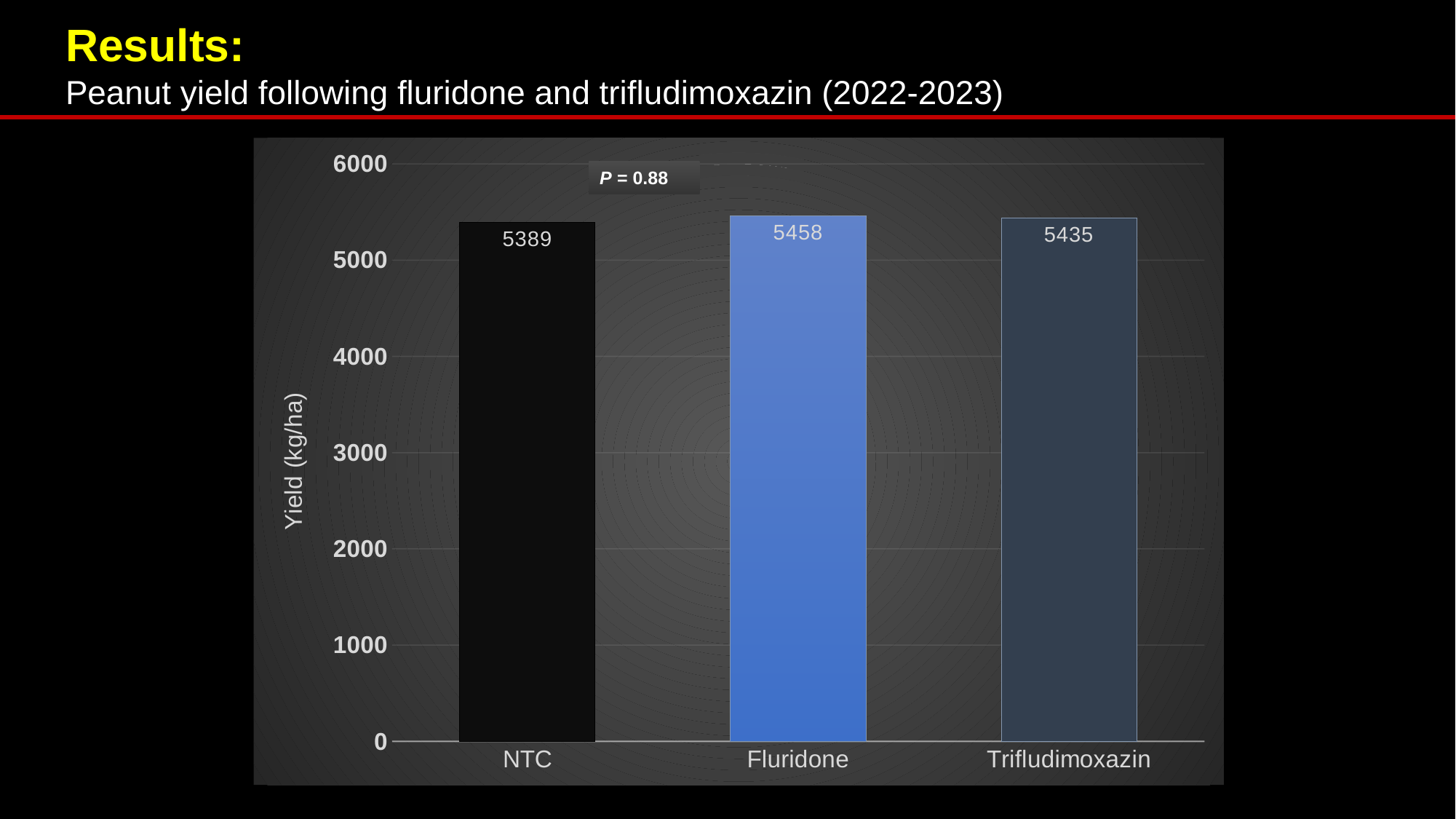
What is the yield value for Fluridone? 5458 What P value is shown on the chart? P = 0.88 What is the difference in yield between Trifludimoxazin and NTC? 46 Which treatment has the lowest yield? NTC What is the yield value for NTC? 5389 What is the yield value for Trifludimoxazin? 5435 What kind of chart is shown on the slide? bar chart Which has a larger yield, Fluridone or Trifludimoxazin? Fluridone Which treatment has the highest yield? Fluridone How many treatments are shown on the x axis? 3 Is the yield for NTC greater or less than 5000? greater What is the difference in yield between Fluridone and NTC? 69